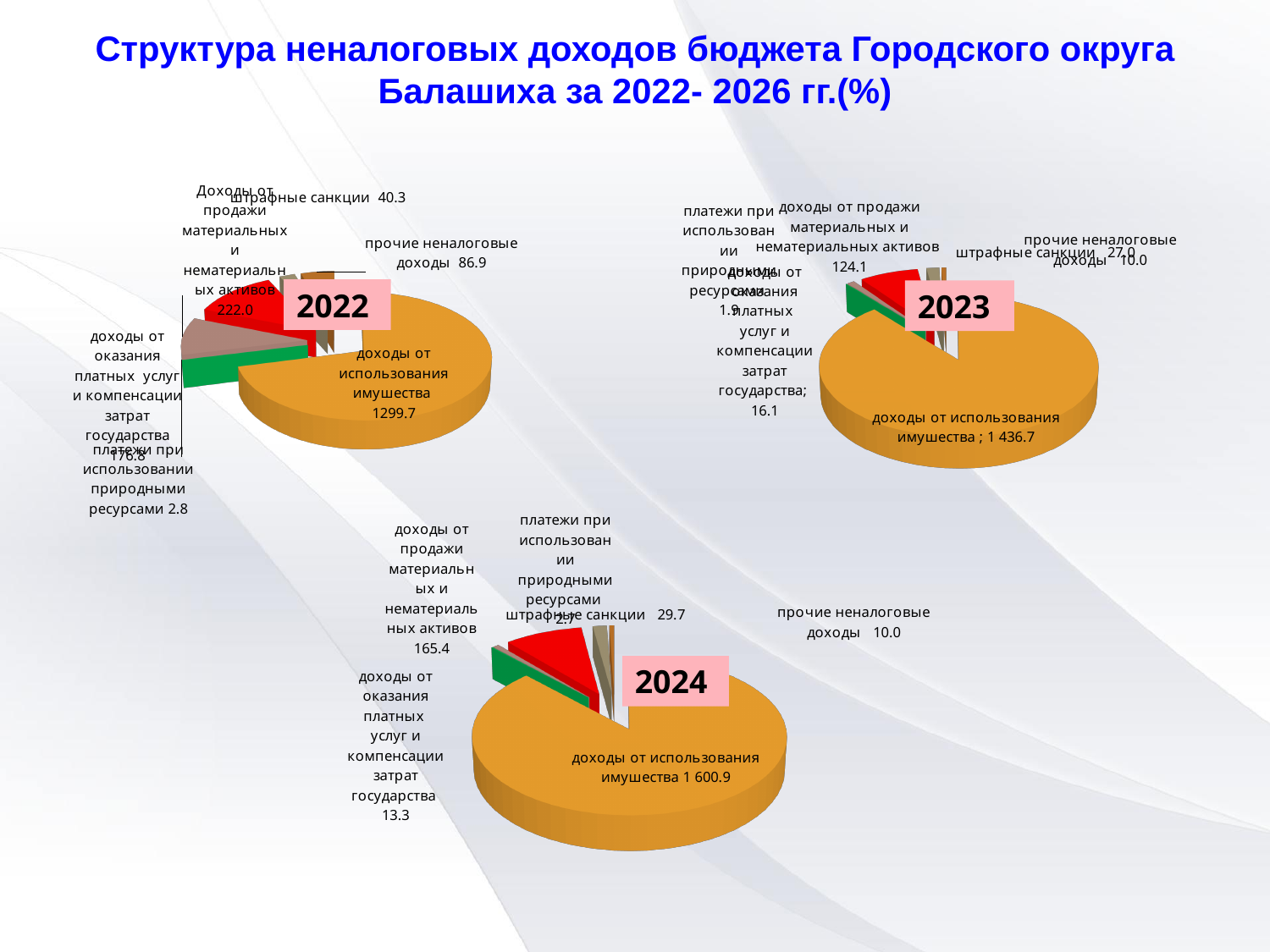
How many pie charts are shown on the slide? 3 In the 2022 chart, what is the value for доходы от использования имущества? 1299.7 In the 2022 chart, what is the difference between доходы от продажи материальных и нематериальных активов (222.0) and прочие неналоговые доходы (86.9)? 135.1 In the 2024 chart, what is the value for доходы от использования имущества? 1 600.9 What kind of chart is used for the 2022 data on the slide? Pie chart In the 2022 chart, what is the value for штрафные санкции? 40.3 In the 2024 chart, which is larger: штрафные санкции or прочие неналоговые доходы? штрафные санкции In the 2023 chart, what is the value for доходы от продажи материальных и нематериальных активов? 124.1 In the 2024 chart, which category has the largest value? доходы от использования имущества In the 2024 chart, what is the value for доходы от оказания платных услуг и компенсации затрат государства? 13.3 In the 2022 chart, what is the value for прочие неналоговые доходы? 86.9 In the 2023 chart, what is the value for доходы от использования имущества? 1 436.7